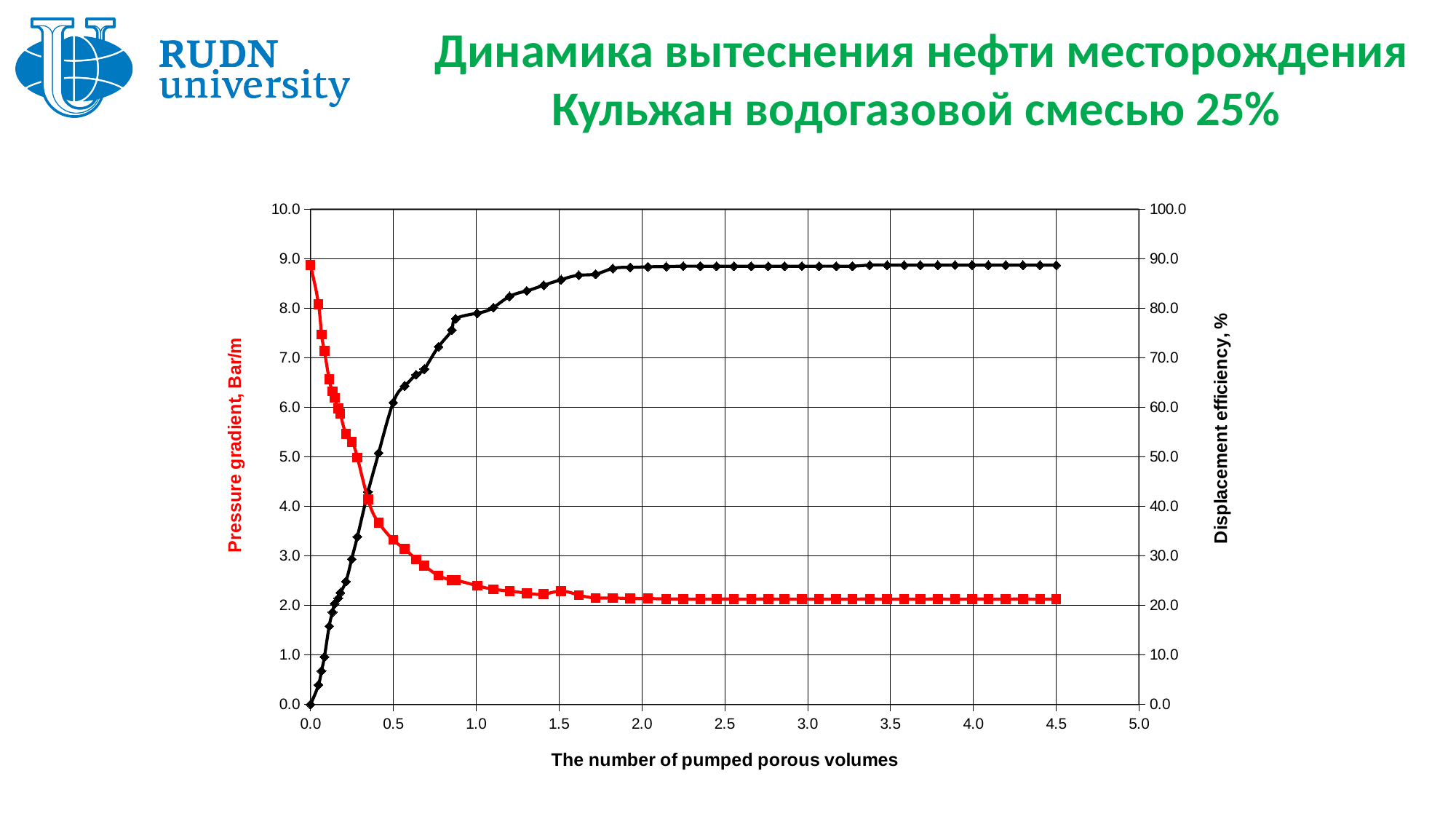
Is the displacement efficiency at 0.5 pumped porous volumes greater or less than 50.0%? greater Is the pressure gradient at 0.0 pumped porous volumes greater or less than 8.0 Bar/m? greater What is the title of the x axis of the chart? The number of pumped porous volumes Is the displacement efficiency at 1.0 pumped porous volumes greater or less than 70.0%? greater What is the title of the right-hand y axis of the chart? Displacement efficiency, % What kind of chart is shown on the slide? line chart Does the pressure gradient (red line) rise or fall as the number of pumped porous volumes increases? fall Does the displacement efficiency (black line) rise or fall as the number of pumped porous volumes increases? rise